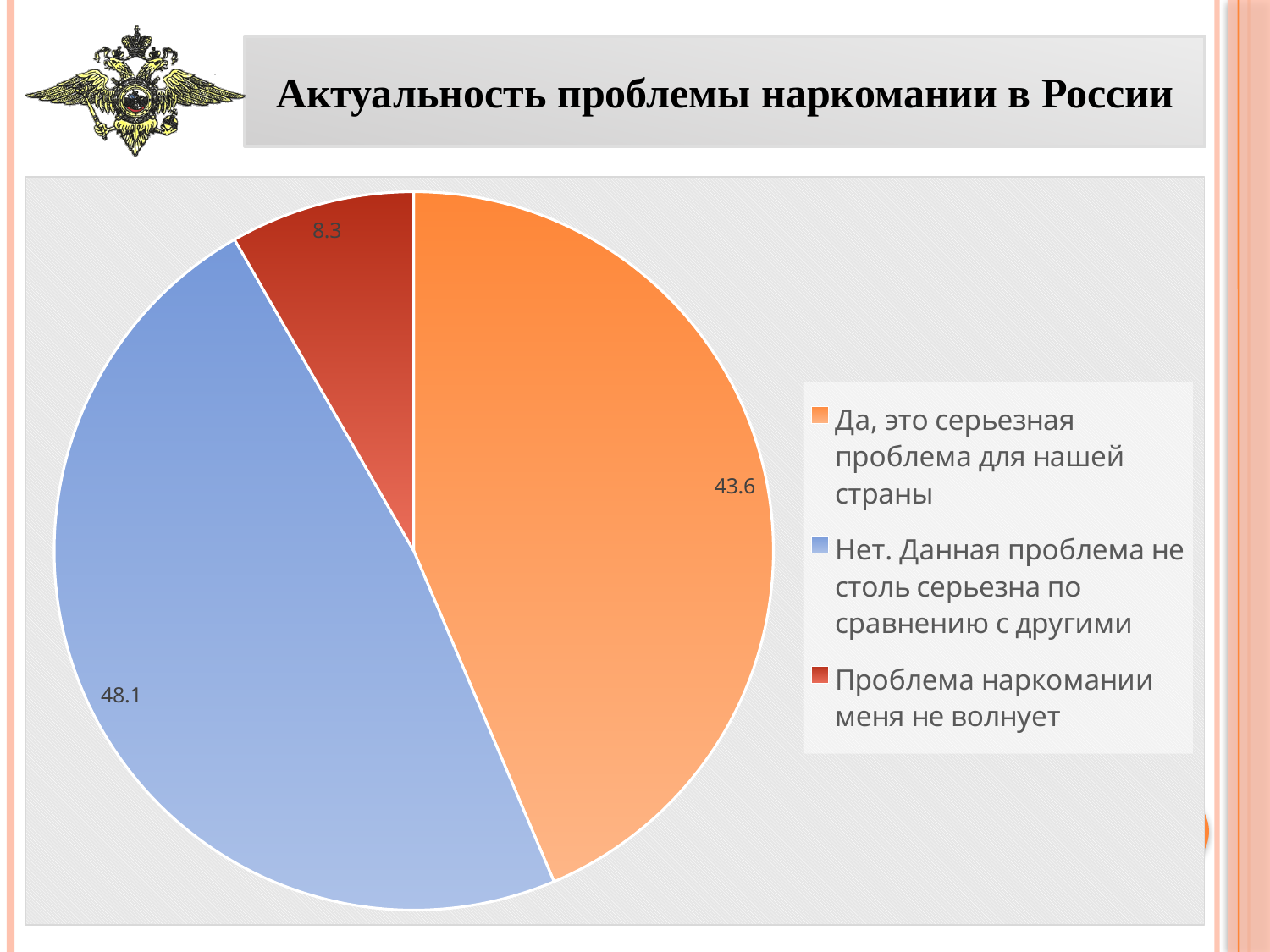
How many slices does the pie chart have? 3 What is the value for "Проблема наркомании меня не волнует"? 8.3 What is the difference between the values for "Нет. Данная проблема не столь серьезна по сравнению с другими" and "Да, это серьезная проблема для нашей страны"? 4.5 How many entries does the legend of the pie chart list? 3 Which is larger: the value for "Да, это серьезная проблема для нашей страны" or the value for "Проблема наркомании меня не волнует"? Да, это серьезная проблема для нашей страны What colour is the slice for "Проблема наркомании меня не волнует"? red Which category has the smallest slice of the pie? Проблема наркомании меня не волнует Which category has the largest slice of the pie? Нет. Данная проблема не столь серьезна по сравнению с другими What is the difference between the values for "Да, это серьезная проблема для нашей страны" and "Проблема наркомании меня не волнует"? 35.3 What is the value for "Да, это серьезная проблема для нашей страны"? 43.6 What type of chart is shown on the slide? pie chart What is the value for "Нет. Данная проблема не столь серьезна по сравнению с другими"? 48.1